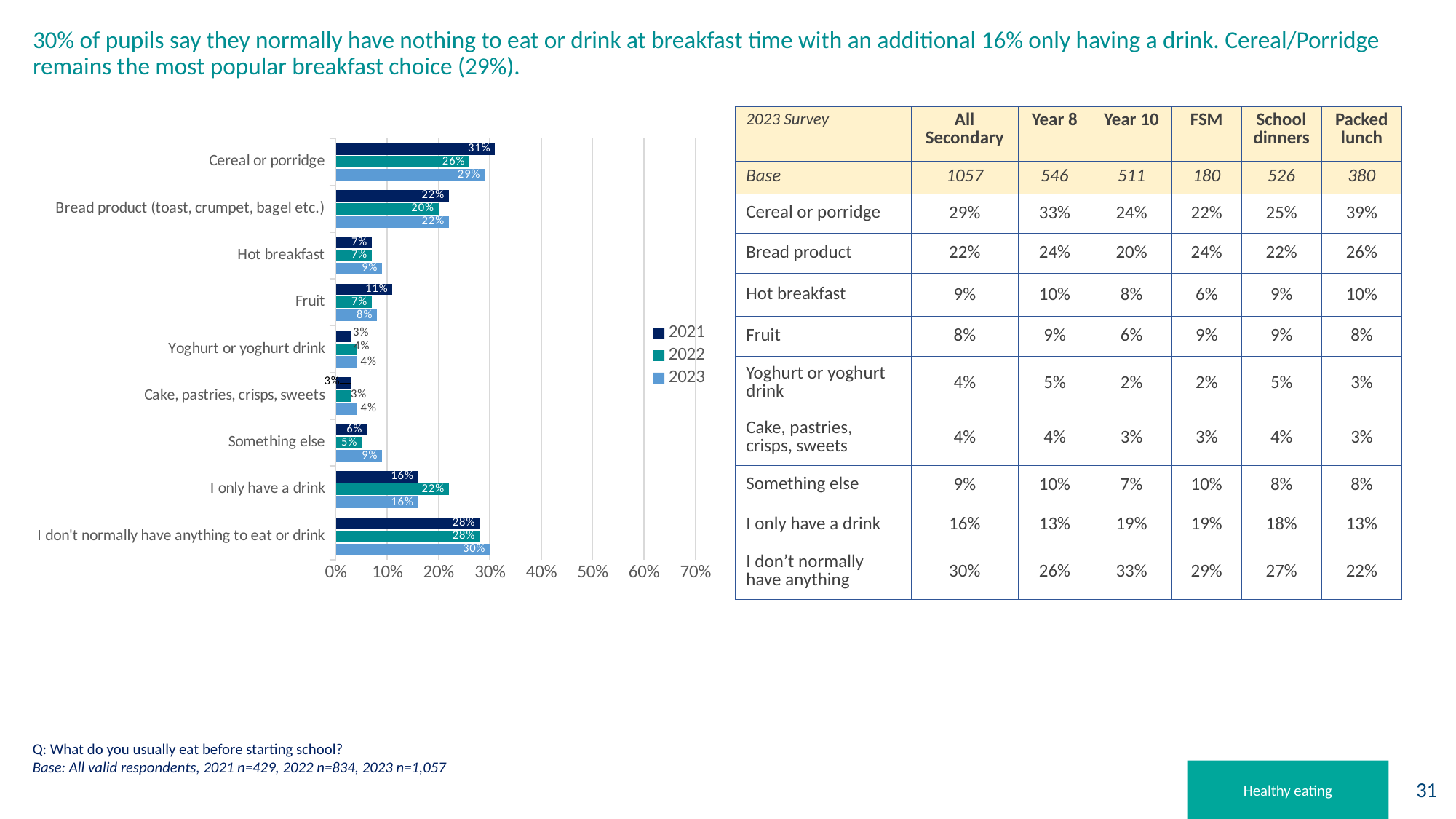
What is the difference between the 2021 and 2022 values for 'Cereal or porridge' in the chart? 5% How many series does the chart legend list? 3 What is the 2023 value for 'Cereal or porridge' in the chart? 29% Which category has the highest 2023 value in the chart? I don't normally have anything to eat or drink What kind of chart is shown on the slide? bar chart How many categories are plotted on the chart? 9 What is the 2021 value for 'Fruit' in the chart? 11% What is the 2022 value for 'I only have a drink' in the chart? 22% Is the 2023 value for 'I don't normally have anything to eat or drink' greater or less than 20%? greater Which year does the lightest blue series in the chart legend represent? 2023 Which is larger in the chart: the 2023 value for 'Something else' or the 2023 value for 'Fruit'? Something else